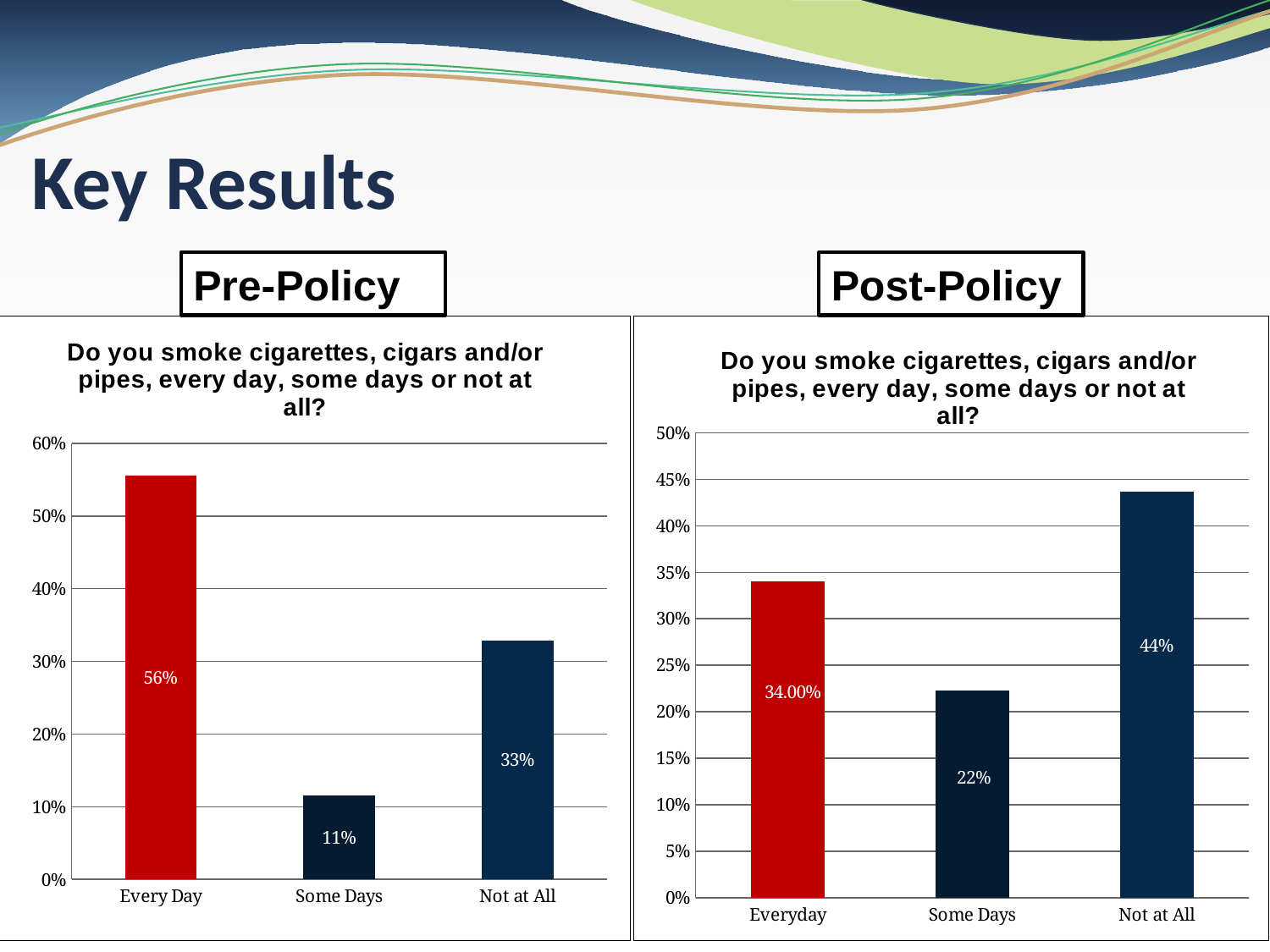
In the Pre-Policy chart, which category has the highest value? Every Day In the Pre-Policy chart, is the value for Not at All greater or less than 40%? less In the Post-Policy chart, which category has the lowest value? Some Days How many categories are shown in the Post-Policy chart? 3 In the Pre-Policy chart, what is the value for Every Day? 56% What kind of chart is the Pre-Policy chart? bar chart In the Pre-Policy chart, what is the value for Some Days? 11% In the Pre-Policy chart, what is the difference between the values for Every Day and Not at All? 23% In the Post-Policy chart, what is the difference between the values for Not at All and Some Days? 22% In the Post-Policy chart, which is larger, the value for Everyday or the value for Not at All? Not at All In the Post-Policy chart, what is the value for Not at All? 44% In the Post-Policy chart, what is the value for Everyday? 34.00%